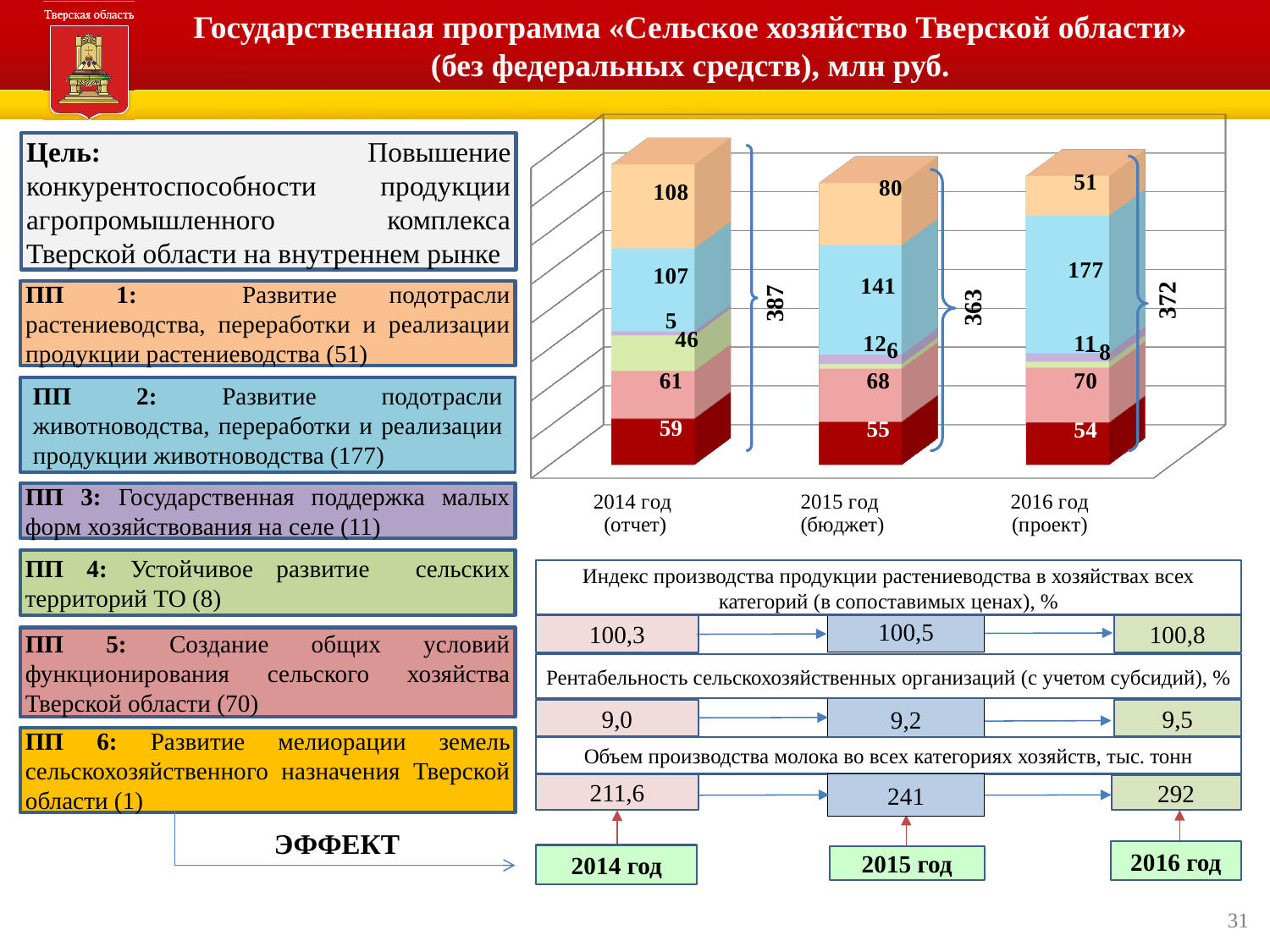
What is the total value of the stacked bar for 2015 год (бюджет)? 363 What is the total value of the stacked bar for 2016 год (проект)? 372 What is the value of the bottom (dark red) segment of the 2014 год bar? 59 Which year has the lowest total in the stacked bar chart? 2015 год (бюджет) Which year has the highest total in the stacked bar chart? 2014 год (отчет) What is the difference between the totals of the 2014 and 2015 bars? 24 How many stacked bars are shown in the chart? 3 What is the total value of the stacked bar for 2014 год (отчет)? 387 What is the value of the light blue segment of the 2016 год bar? 177 Does the top (orange) segment rise or fall from 2014 to 2016? fall What is the value of the top (orange) segment of the 2015 год bar? 80 Which is larger: the light blue segment in 2014 or the light blue segment in 2016? 2016